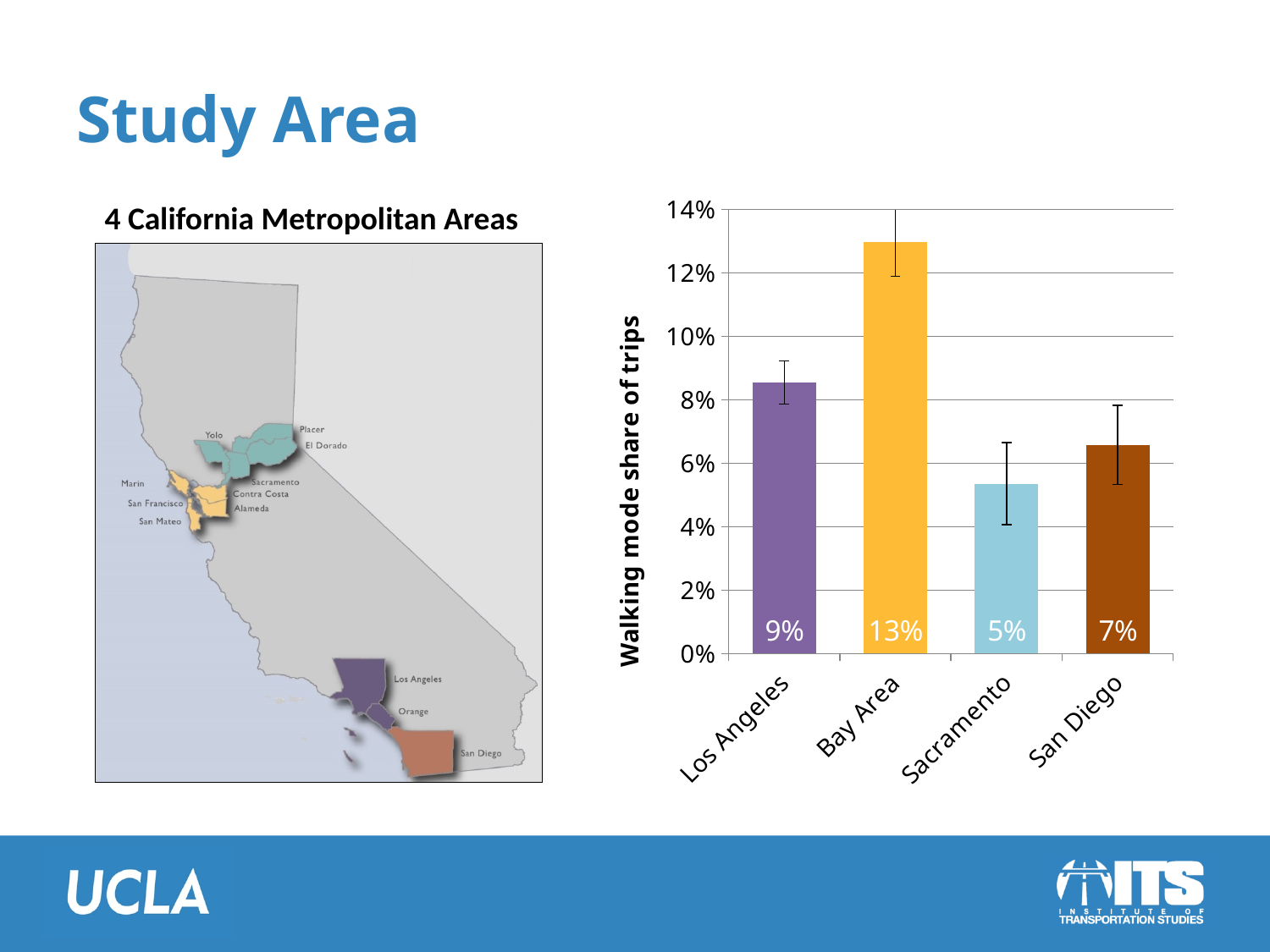
Which metropolitan area has the lowest walking mode share of trips? Sacramento Which has a higher walking mode share of trips, Los Angeles or San Diego? Los Angeles What is the walking mode share of trips for Sacramento? 5% What is the difference in walking mode share between the Bay Area and Sacramento, using the data labels? 8% What is the walking mode share of trips for Los Angeles? 9% What is the walking mode share of trips for San Diego? 7% Which metropolitan area has the highest walking mode share of trips? Bay Area How many metropolitan areas are shown in the bar chart? 4 What type of chart is used to show walking mode share of trips? Bar chart Is the walking mode share for the Bay Area greater or less than 12%? greater What is the walking mode share of trips for the Bay Area? 13% What is the label on the vertical axis of the chart? Walking mode share of trips